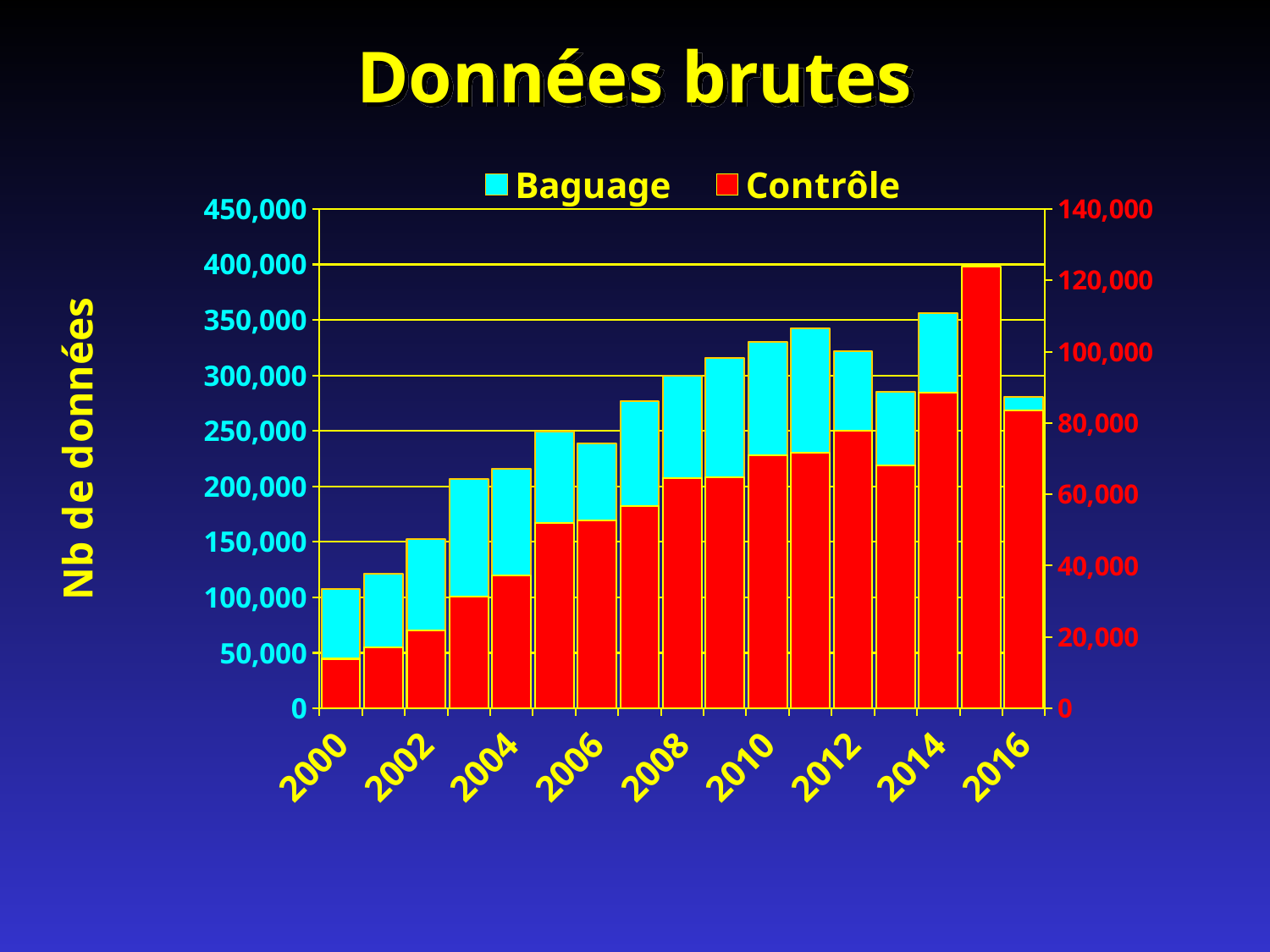
Is the top of the 2000 bar greater or less than 150,000 on the left axis? less Is the top of the 2014 bar greater or less than 300,000 on the left axis? greater What type of chart is shown on the slide? bar chart What is the title of the chart? Données brutes Is the top of the 2008 bar greater or less than 250,000 on the left axis? greater Which year has the shortest bar overall? 2000 Which bar is taller, 2012 or 2013? 2012 Do the bar heights generally rise or fall from 2000 to 2010? rise How many series does the legend list? 2 Which year has the tallest bar overall? 2015 How many years (bars) are plotted along the x axis? 17 What are the two series named in the legend? Baguage and Contrôle